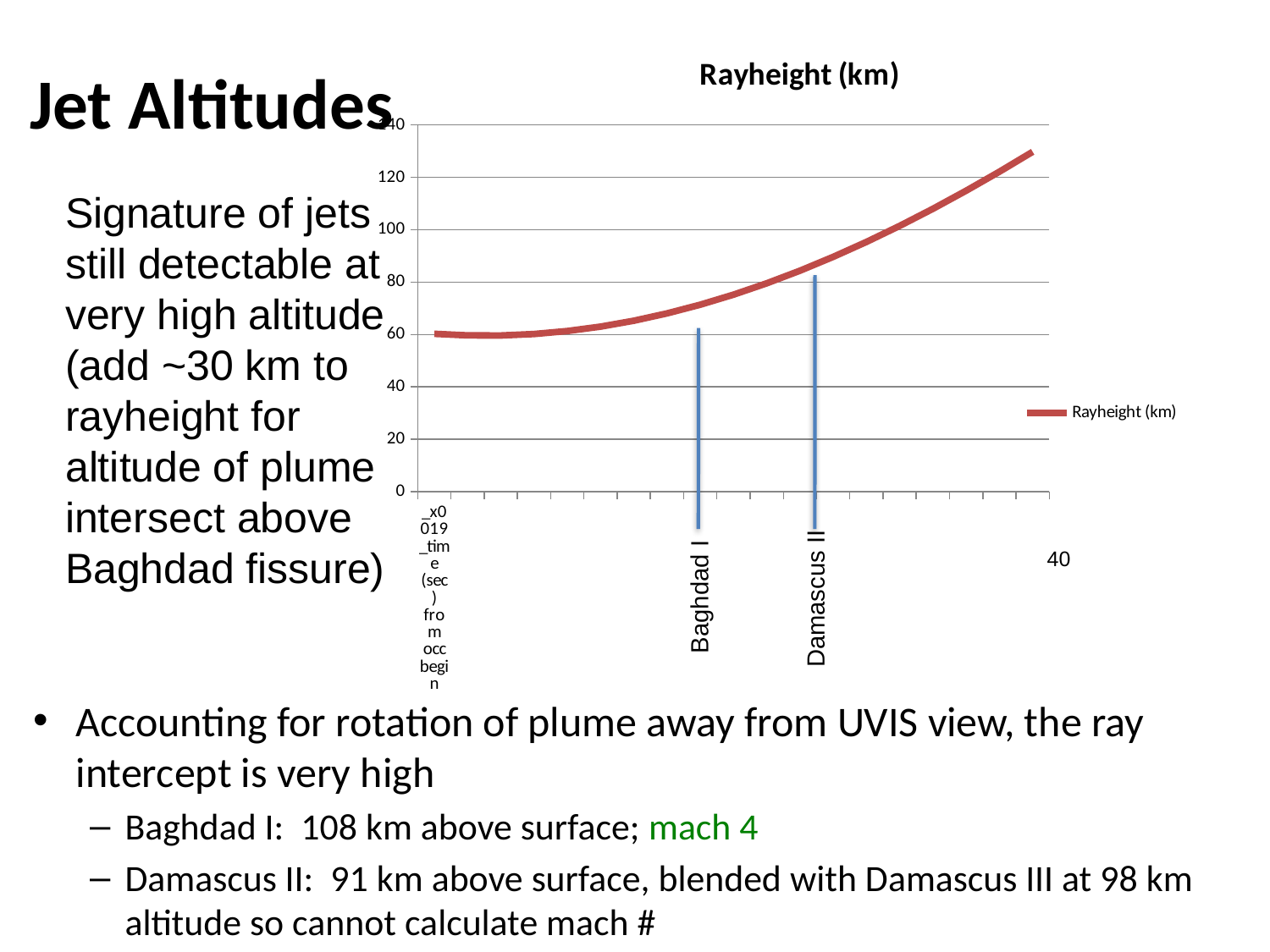
What is the name of the series listed in the chart legend? Rayheight (km) What is the title of the chart? Rayheight (km) Is the value of the Rayheight (km) line at the right end of the chart greater or less than 120? greater Which marker on the chart corresponds to a higher rayheight value, Baghdad I or Damascus II? Damascus II What kind of chart is shown on the slide? line chart Does the Rayheight (km) line generally rise or fall from left to right along the x axis? rise What is the highest value shown on the chart's y axis? 140 Is the value of the Rayheight (km) line at the Baghdad I marker greater or less than 40? greater Is the value of the Rayheight (km) line at the Damascus II marker greater or less than 60? greater How many series does the chart legend list? 1